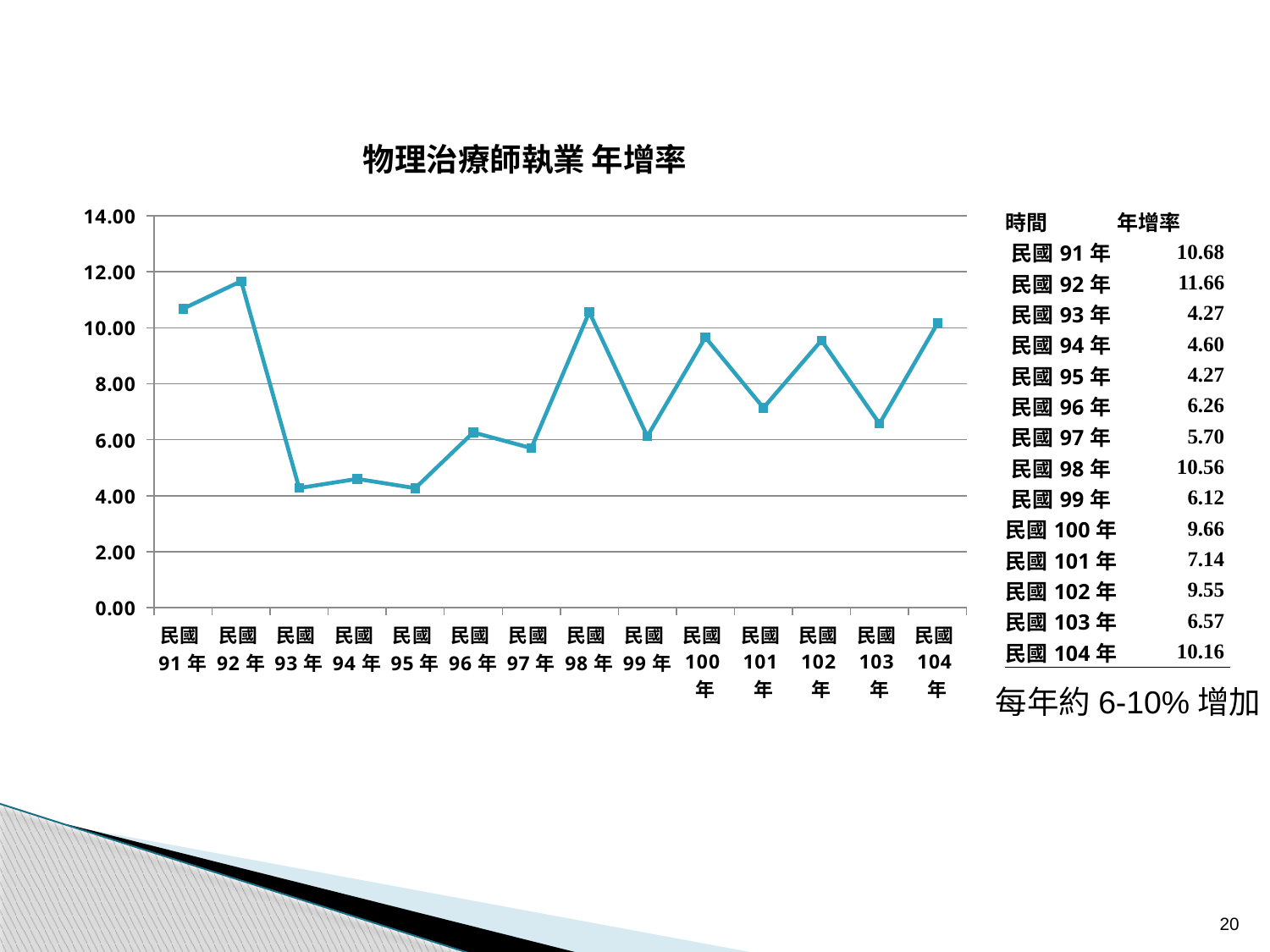
What is the annual growth rate for 民國 104 年? 10.16 Which year has the highest annual growth rate? 民國 92 年 What is the title of the chart? 物理治療師執業 年增率 What type of chart is shown on the slide? line chart What is the difference between the growth rates of 民國 98 年 and 民國 97 年? 4.86 What is the difference between the growth rates of 民國 92 年 and 民國 91 年? 0.98 Is the value for 民國 101 年 greater or less than 6.00? greater What is the annual growth rate (年增率) for 民國 92 年? 11.66 What is the annual growth rate for 民國 98 年? 10.56 Does the line rise or fall from 民國 92 年 to 民國 93 年? fall Which is larger, the growth rate for 民國 100 年 or 民國 102 年? 民國 100 年 How many data points are plotted on the line? 14